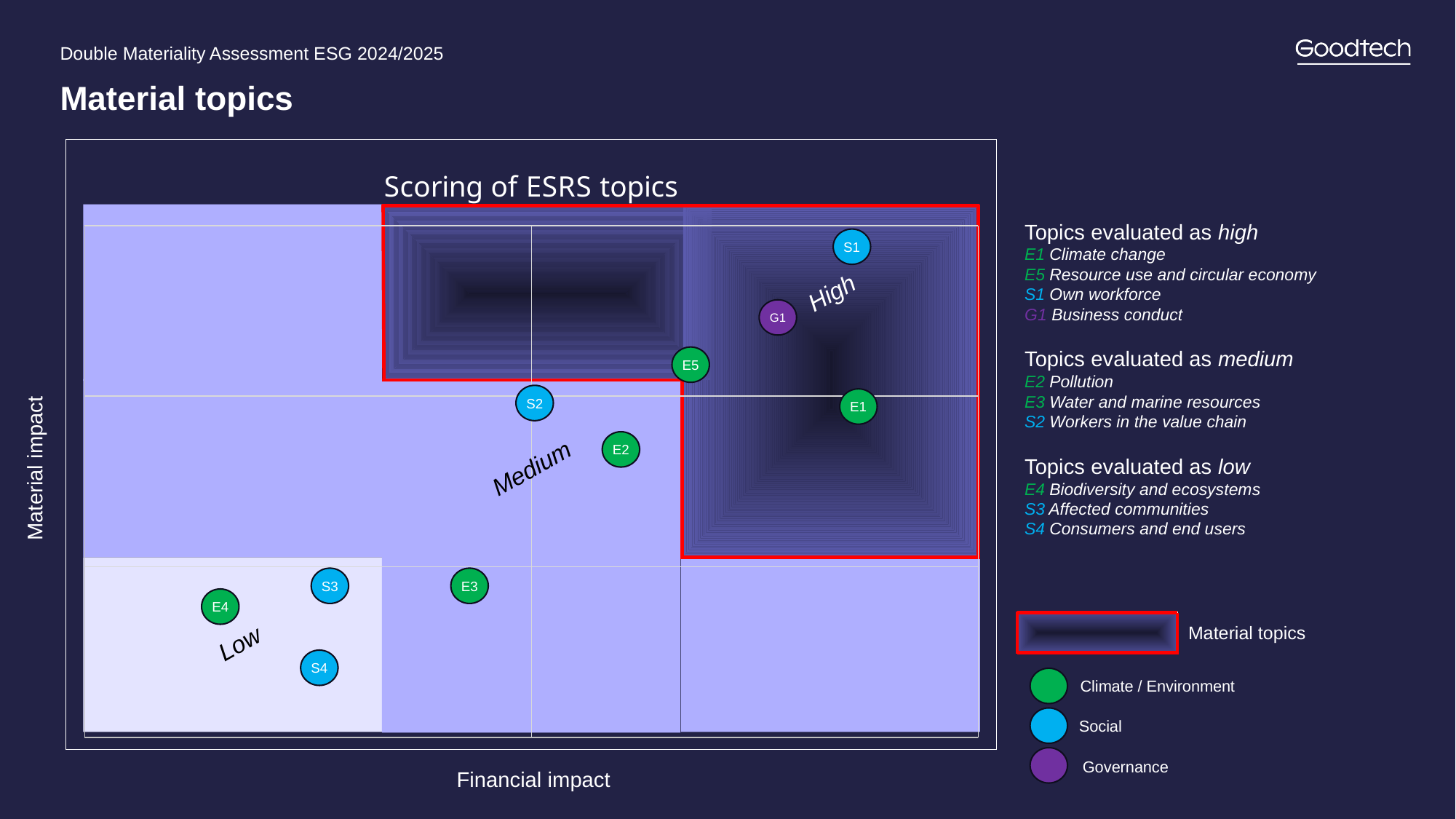
Which has the higher material impact on the chart, S2 or E2? S2 Which has the higher material impact on the chart, S1 or E1? S1 What kind of chart is shown on the slide? Scatter chart How many topic points are plotted on the chart? 10 In which scoring region (Low, Medium or High) does topic E3 fall on the chart? Medium Which topic point has the lowest financial impact on the chart? E4 Which topic point has the highest material impact on the chart? S1 Which topic point has the lowest material impact on the chart? S4 What is the title of the chart? Scoring of ESRS topics In which scoring region (Low, Medium or High) does topic E5 fall on the chart? High How many topic points fall in the High region of the chart? 4 What is the label of the horizontal axis of the chart? Financial impact